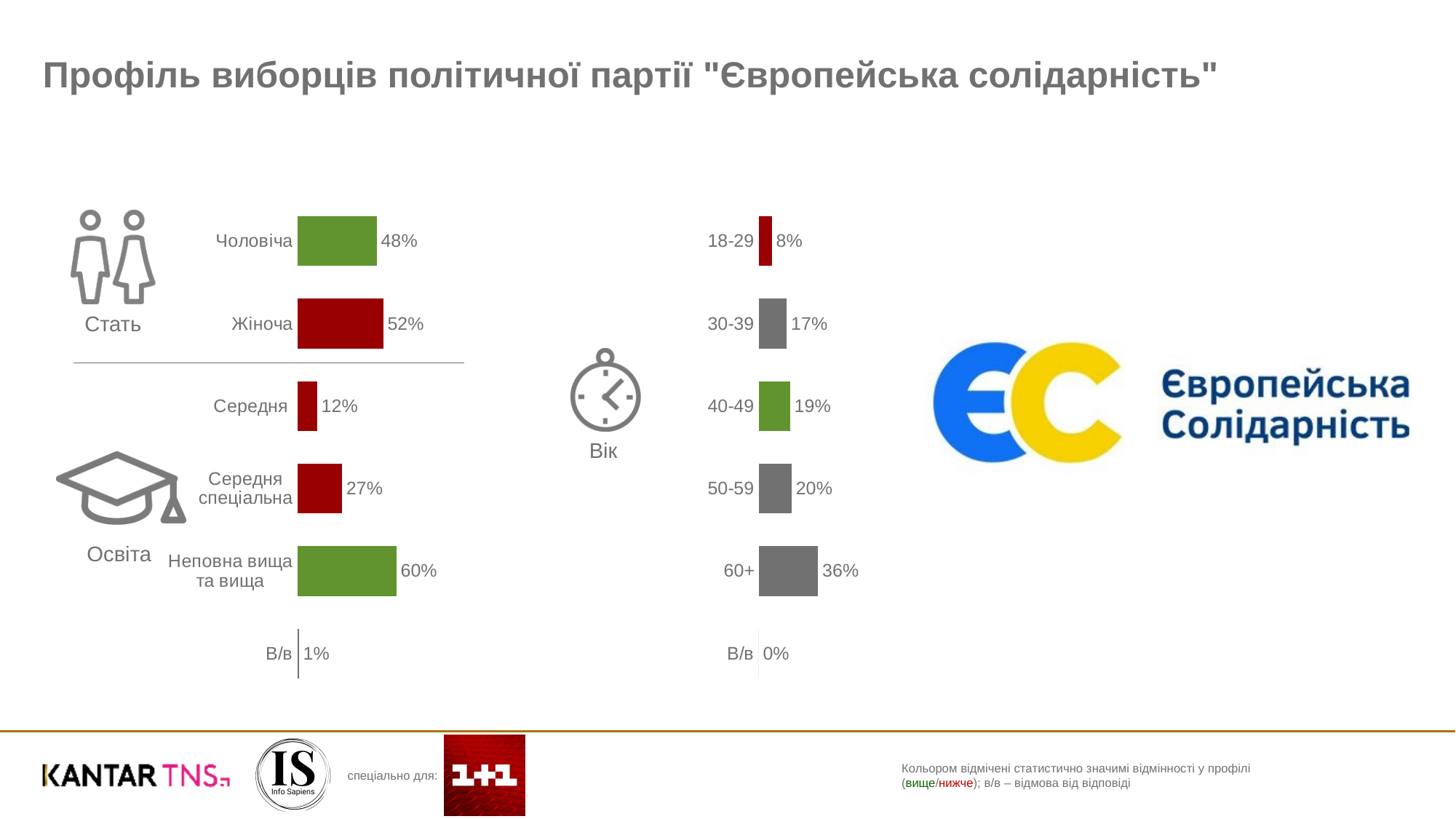
In the Стать (gender) chart, what is the value for Жіноча? 52% In the Вік (age) chart, which is larger: 40-49 or 30-39? 40-49 In the Стать (gender) chart, what is the difference between Жіноча and Чоловіча? 4% How many age groups (excluding В/в) are shown in the Вік (age) chart? 5 In the Вік (age) chart, which age group has the lowest value, excluding В/в? 18-29 What type of chart is used for the Вік (age) data? Bar chart In the Освіта (education) chart, what is the difference between Середня спеціальна and Середня? 15% In the Стать (gender) chart, what is the value for Чоловіча? 48% In the Освіта (education) chart, which category has the highest value? Неповна вища та вища In the Вік (age) chart, what is the difference between the 60+ group and the 50-59 group? 16% In the Освіта (education) chart, what is the value for Неповна вища та вища? 60% In the Вік (age) chart, what is the value for the 60+ group? 36%